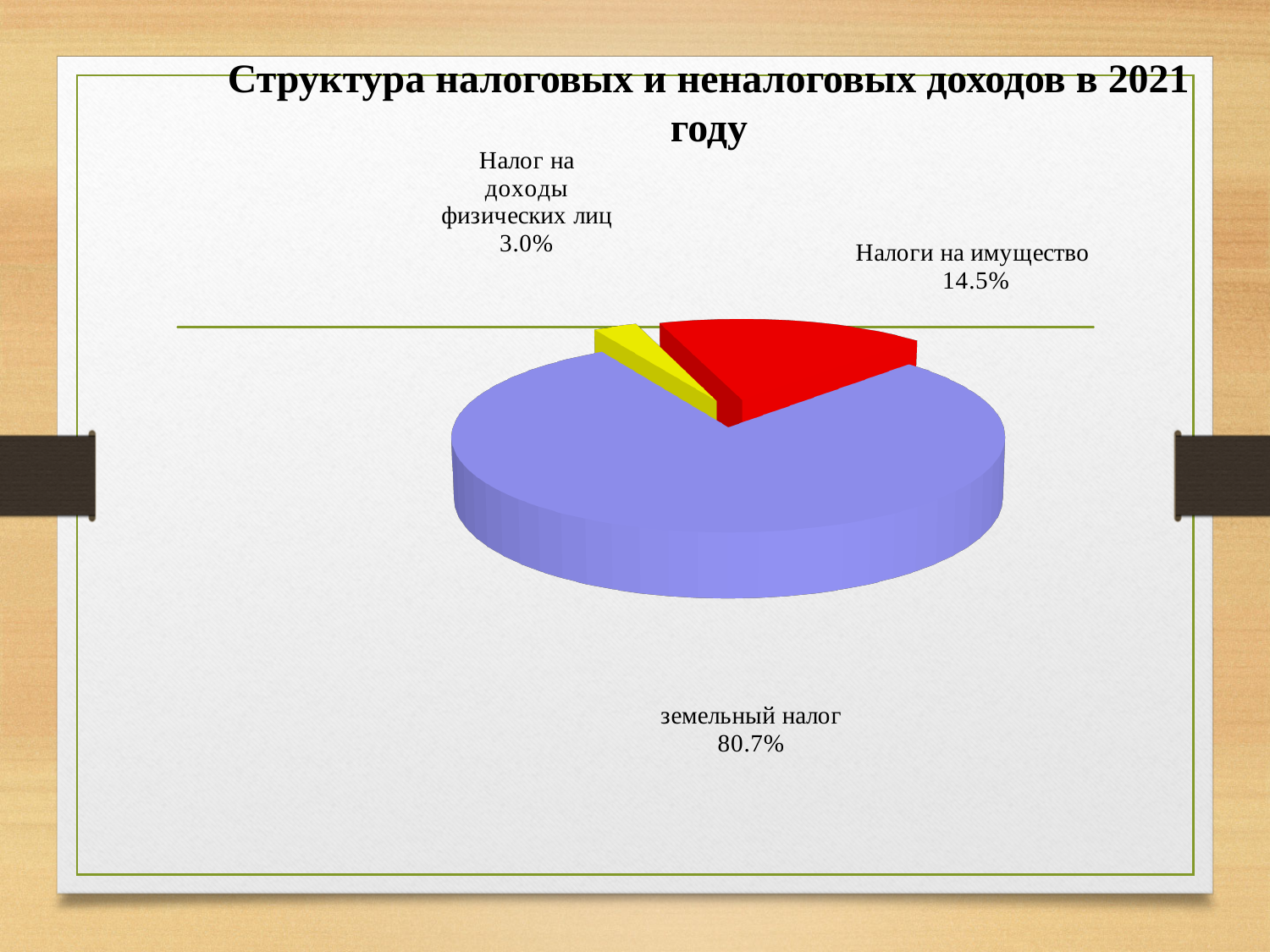
Which is larger, the share for Налоги на имущество or the share for Налог на доходы физических лиц? Налоги на имущество What is the difference in percentage points between земельный налог and Налоги на имущество? 66.2 What is the share for Налоги на имущество? 14.5% What colour is the slice for Налоги на имущество? Red What is the share for Налог на доходы физических лиц? 3.0% Which category has the smallest slice of the pie? Налог на доходы физических лиц What is the difference in percentage points between Налоги на имущество and Налог на доходы физических лиц? 11.5 How many slices does the pie chart have? 3 Which category has the largest slice of the pie? земельный налог What kind of chart is shown on the slide? Pie chart What is the share for земельный налог? 80.7% What is the title of the chart? Структура налоговых и неналоговых доходов в 2021 году